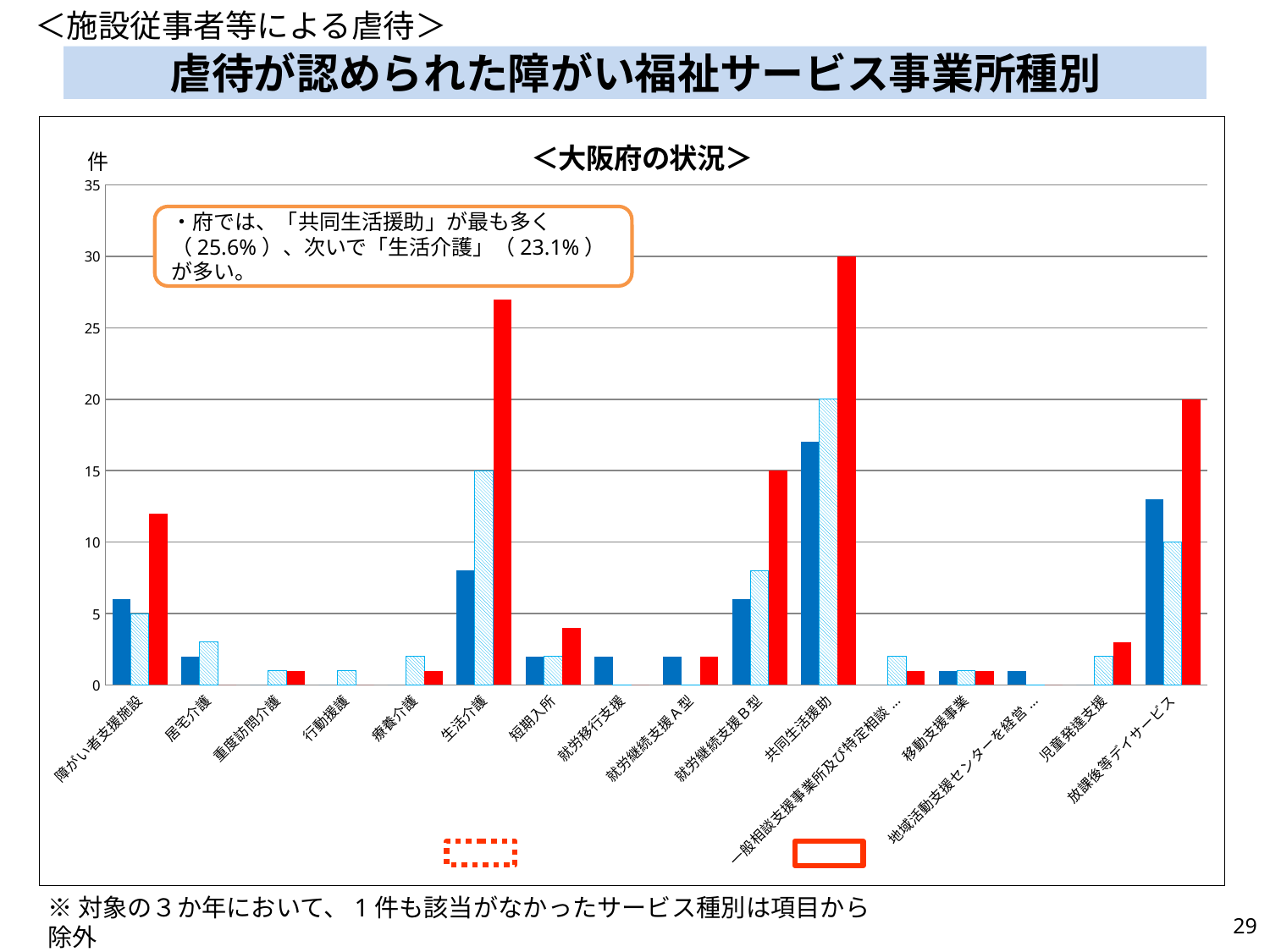
What is the value of the red bar for 就労継続支援B型? 15 What is the value of the red bar for 放課後等デイサービス? 20 Is the value of the red bar for 生活介護 greater or less than 25? greater What is the difference between the red bar and the hatched light-blue bar for 共同生活援助? 10 Which category has the tallest red bar? 共同生活援助 What is the value of the hatched light-blue bar for 共同生活援助? 20 Which is larger: the red bar for 障がい者支援施設 or the red bar for 放課後等デイサービス? 放課後等デイサービス What is the value of the hatched light-blue bar for 生活介護? 15 How many service categories are shown on the x axis? 16 What is the value of the red bar for 共同生活援助? 30 Is the value of the dark-blue bar for 共同生活援助 greater or less than 15? greater What kind of chart is shown on the slide? bar chart